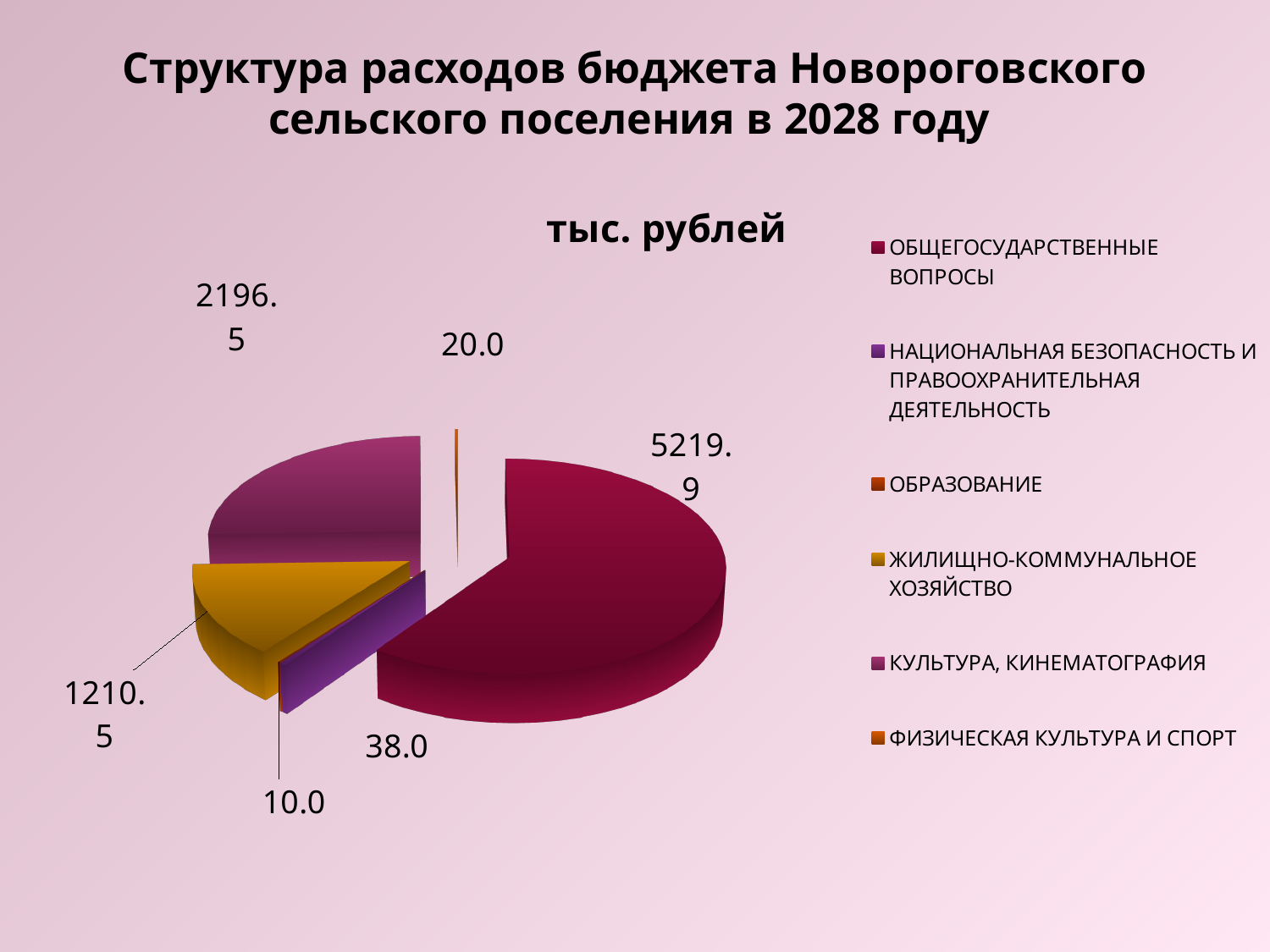
Which category has the smallest value? ОБРАЗОВАНИЕ Which category has the largest slice of the pie? ОБЩЕГОСУДАРСТВЕННЫЕ ВОПРОСЫ What is the value for ОБЩЕГОСУДАРСТВЕННЫЕ ВОПРОСЫ? 5219.9 Which is larger: the value for ЖИЛИЩНО-КОММУНАЛЬНОЕ ХОЗЯЙСТВО or the value for КУЛЬТУРА, КИНЕМАТОГРАФИЯ? КУЛЬТУРА, КИНЕМАТОГРАФИЯ What is the value for НАЦИОНАЛЬНАЯ БЕЗОПАСНОСТЬ И ПРАВООХРАНИТЕЛЬНАЯ ДЕЯТЕЛЬНОСТЬ? 38.0 What is the value for ОБРАЗОВАНИЕ? 10.0 What is the value for ЖИЛИЩНО-КОММУНАЛЬНОЕ ХОЗЯЙСТВО? 1210.5 What is the difference between the values for ОБЩЕГОСУДАРСТВЕННЫЕ ВОПРОСЫ and КУЛЬТУРА, КИНЕМАТОГРАФИЯ? 3023.4 What is the title shown above the pie chart? тыс. рублей What kind of chart is shown on the slide? Pie chart What is the value for КУЛЬТУРА, КИНЕМАТОГРАФИЯ? 2196.5 How many categories does the legend list? 6